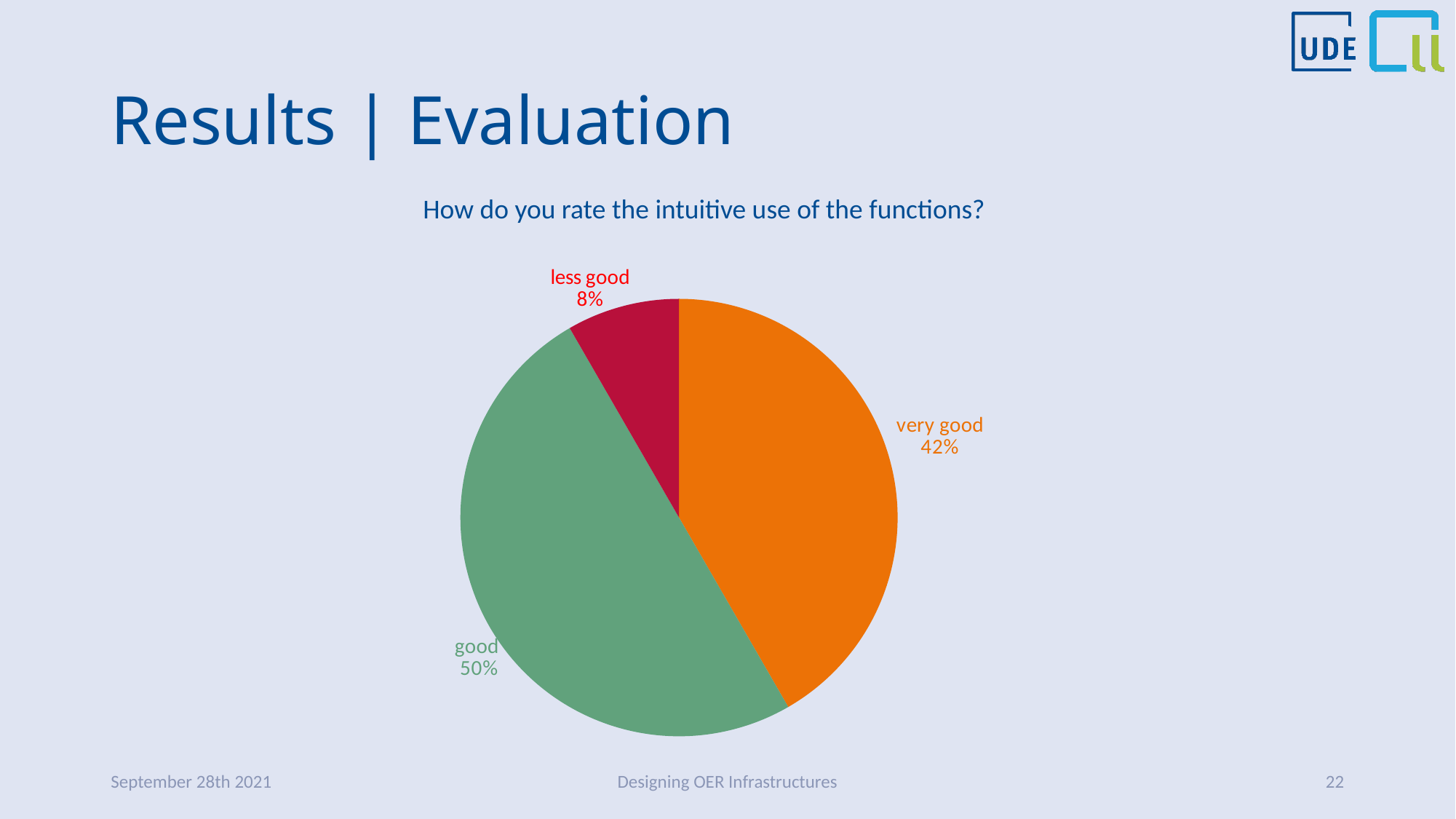
What is the chart's title? How do you rate the intuitive use of the functions? What percentage of respondents rated the intuitive use of the functions as "very good"? 42% How many slices does the pie chart have? 3 What is the difference in percentage points between the "very good" and "less good" slices? 34 What kind of chart is shown on the slide? pie chart Which slice is larger, "very good" or "less good"? very good What percentage of respondents rated the intuitive use of the functions as "good"? 50% What colour is the "good" slice of the pie? green Which rating category has the largest share of the pie? good Which rating category has the smallest share of the pie? less good What percentage of respondents rated the intuitive use of the functions as "less good"? 8% What is the difference in percentage points between the "good" and "very good" slices? 8